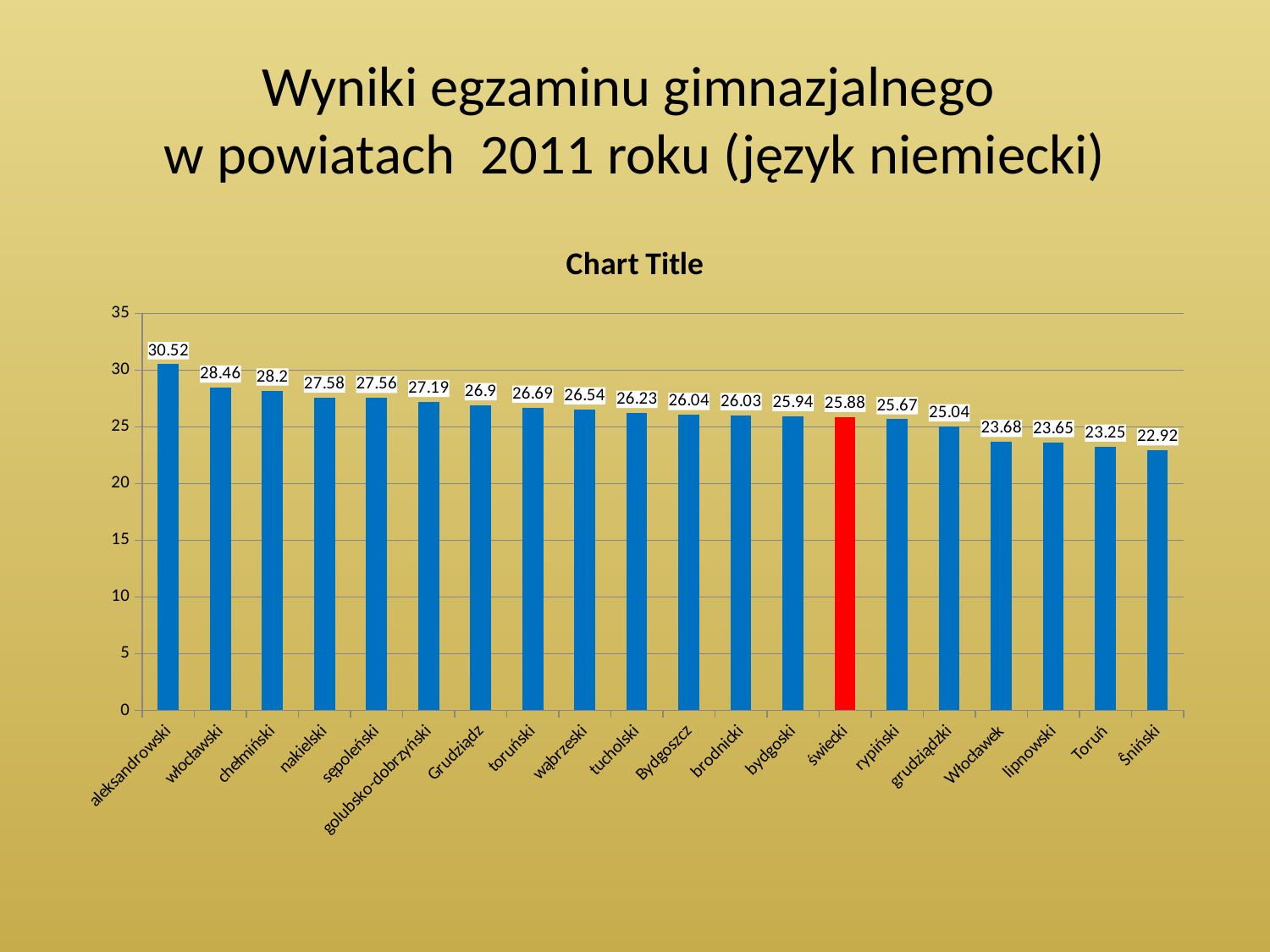
What kind of chart is shown on the slide? bar chart What is the value for Toruń? 23.25 What is the difference between the values for włocławski and Włocławek? 4.78 Which category's bar is coloured red instead of blue? świecki Which category has the lowest value? Ŝniński What is the value for świecki? 25.88 How many categories are shown on the x axis? 20 What is the difference between the values for aleksandrowski and żniński? 7.6 Which category has the highest value? aleksandrowski What is the value for aleksandrowski? 30.52 Is the value for lipnowski greater or less than 25? less Which is larger, the value for chełmiński or the value for grudziądzki? chełmiński